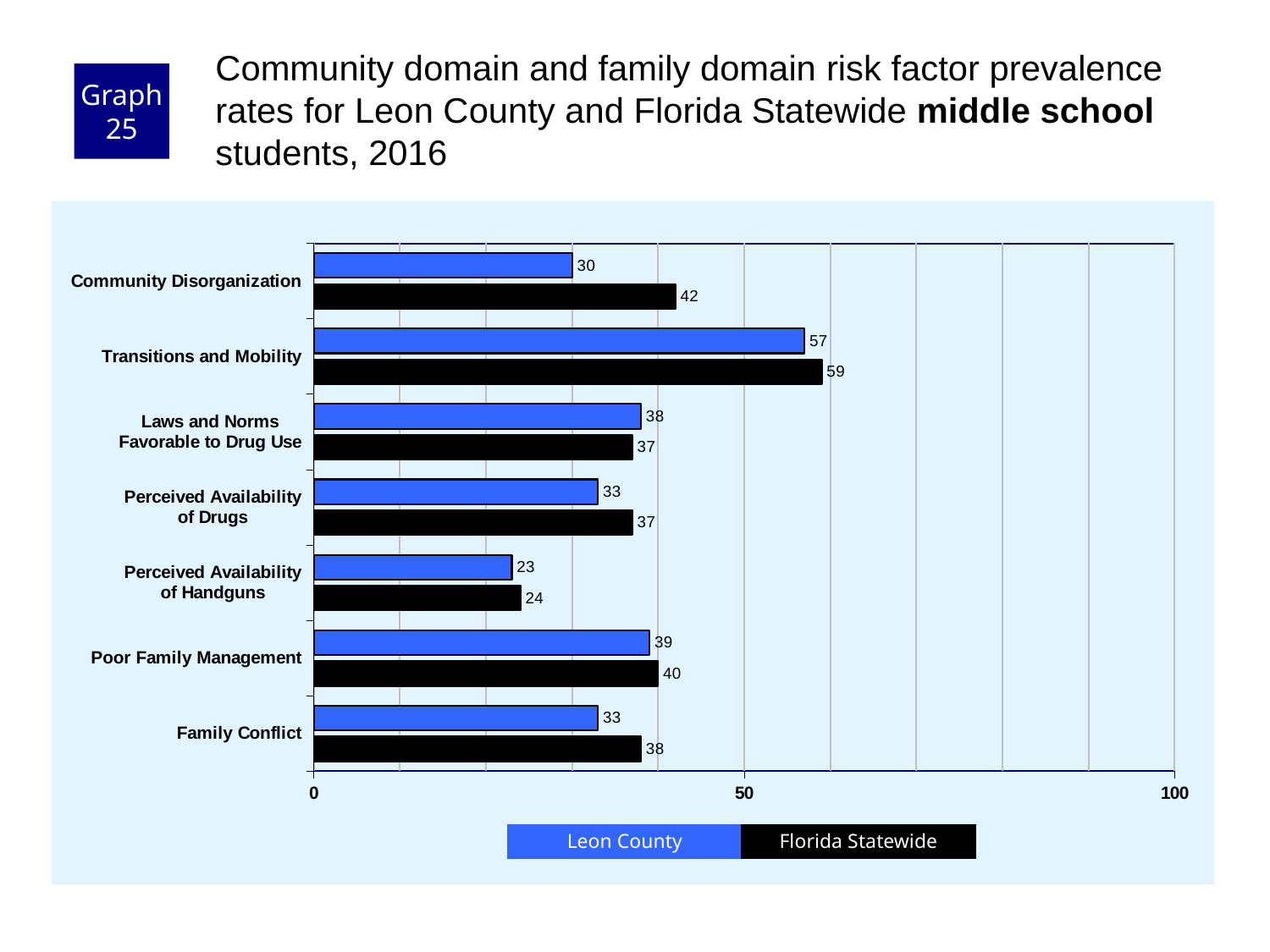
What is the Leon County value for Perceived Availability of Handguns? 23 How many risk factors are shown on the chart? 7 What colour are the Florida Statewide bars? Black How many series does the legend list? 2 Which risk factor has the lowest Florida Statewide value? Perceived Availability of Handguns What is the Florida Statewide value for Transitions and Mobility? 59 For Family Conflict, which is larger: the Leon County value or the Florida Statewide value? Florida Statewide What is the difference between the Florida Statewide and Leon County values for Community Disorganization? 12 What kind of chart is shown on the slide? Bar chart What is the Leon County value for Community Disorganization? 30 Which risk factor has the highest Leon County value? Transitions and Mobility Is the Leon County value for Transitions and Mobility greater or less than 50? greater